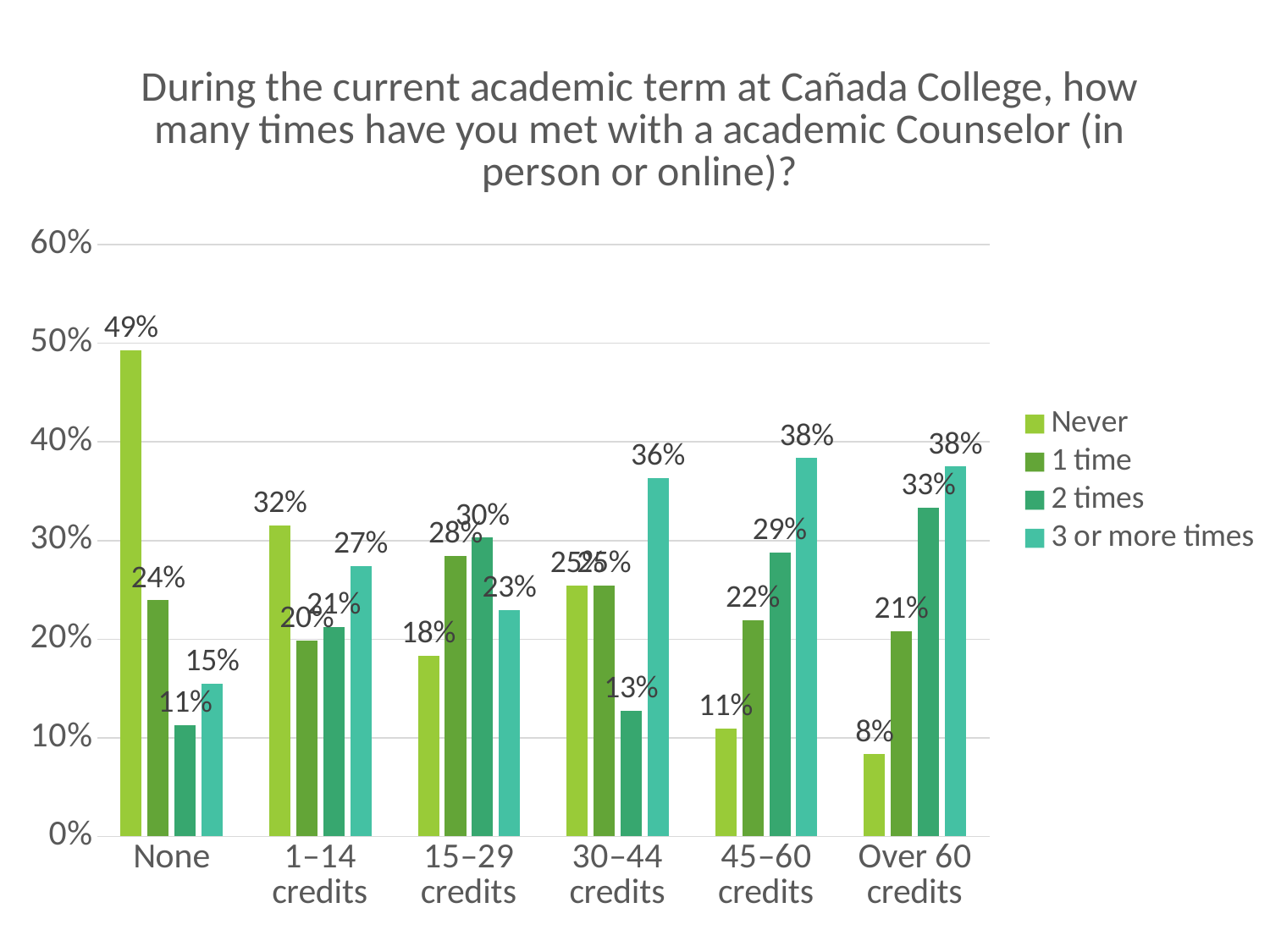
Which credit group has the lowest value for the "Never" series? Over 60 credits Is the "3 or more times" value for 45–60 credits greater or less than 30%? greater Which credit group has the highest value for the "Never" series? None What is the value for "2 times" in the Over 60 credits group? 33% What is the value for "3 or more times" in the 30–44 credits group? 36% How many series does the legend list? 4 In the 45–60 credits group, which is larger: "1 time" or "2 times"? 2 times What is the difference between the "Never" value for None and the "Never" value for Over 60 credits? 41% What kind of chart is shown on the slide? Bar chart How many credit groups are shown on the x axis? 6 Does the "Never" series generally rise or fall as the credit groups increase from None to Over 60 credits? Fall What percentage of students with no credits (None) answered "Never"? 49%